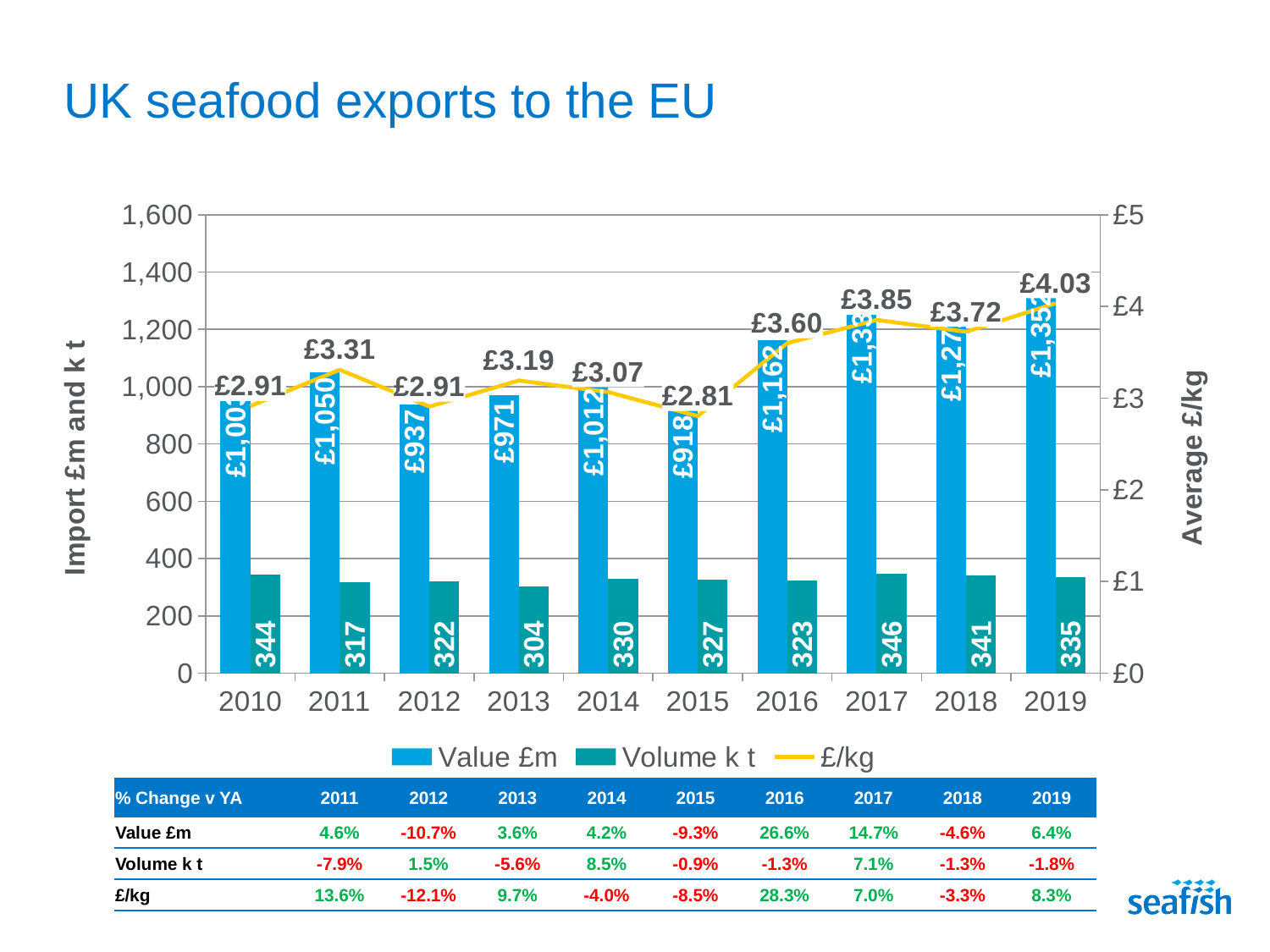
How many series does the legend list? 3 How many years are shown on the x axis? 10 What is the £/kg value for 2019? £4.03 Which year has the lowest £/kg value? 2015 Is the Value £m bar for 2017 greater or less than 1,200? greater What is the Volume k t value for 2013? 304 What is the Value £m for 2016? £1,162 Which year has the highest £/kg value? 2019 What is the difference in £/kg between 2019 and 2018? £0.31 Which year has the larger Value £m, 2012 or 2013? 2013 Which year has the lowest Volume k t? 2013 What is the difference in Volume k t between 2017 and 2011? 29